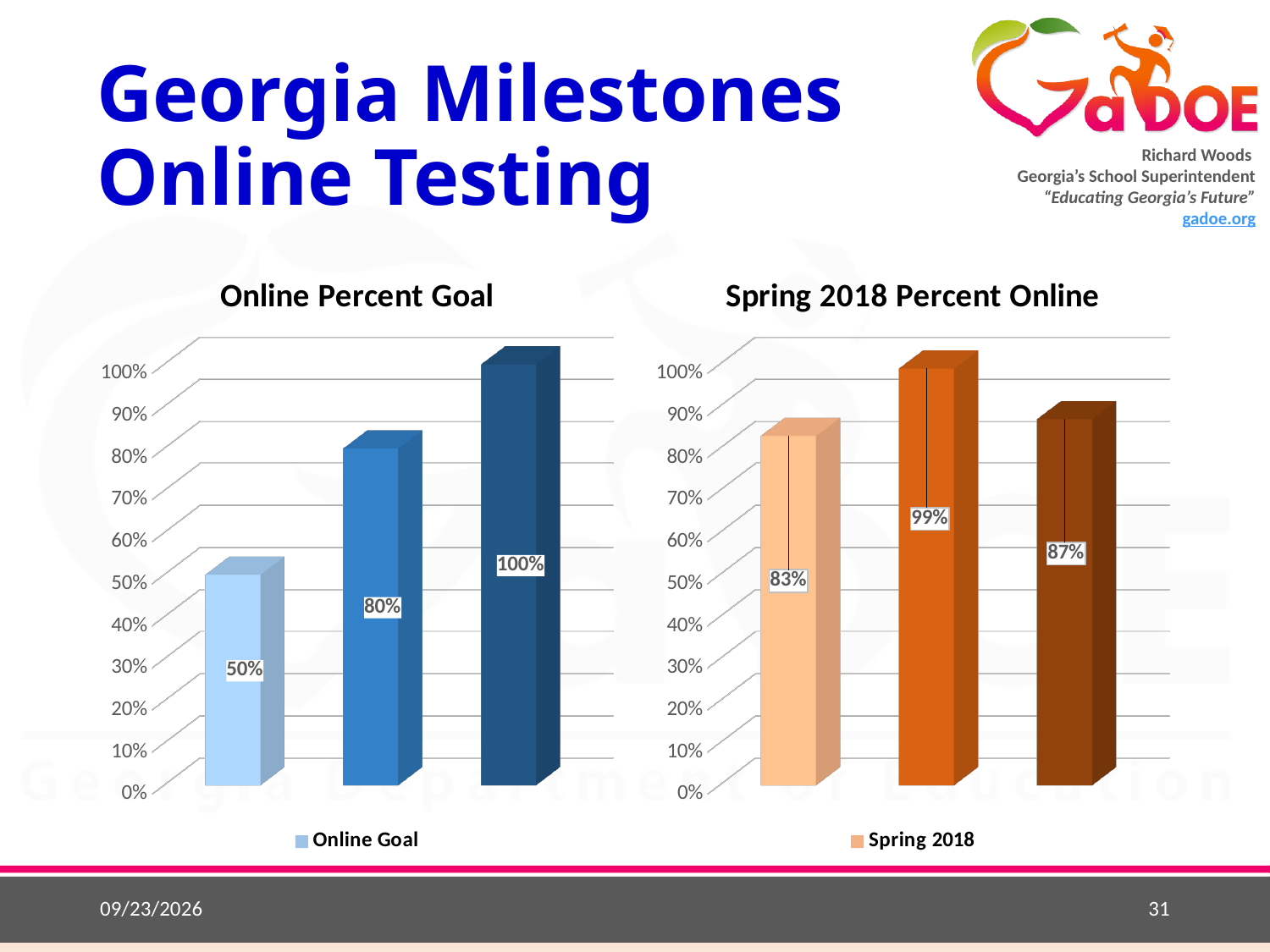
In the 'Spring 2018 Percent Online' chart, what is the value of the middle bar? 99% In the 'Online Percent Goal' chart, what is the difference between the highest and lowest bar values? 50% In the 'Spring 2018 Percent Online' chart, what is the lowest value shown? 83% In the 'Spring 2018 Percent Online' chart, what is the difference between the middle bar and the rightmost bar? 12% In the 'Spring 2018 Percent Online' chart, which is larger: the leftmost bar or the rightmost bar? the rightmost bar (87%) What series name does the legend of the 'Spring 2018 Percent Online' chart show? Spring 2018 In the 'Spring 2018 Percent Online' chart, what is the value of the rightmost bar? 87% In the 'Online Percent Goal' chart, what is the value of the middle bar? 80% In the 'Spring 2018 Percent Online' chart, what is the highest value shown? 99% What type of chart is the 'Spring 2018 Percent Online' chart? bar chart In the 'Online Percent Goal' chart, what is the value of the first (leftmost) bar? 50% How many bars are plotted in the 'Online Percent Goal' chart? 3